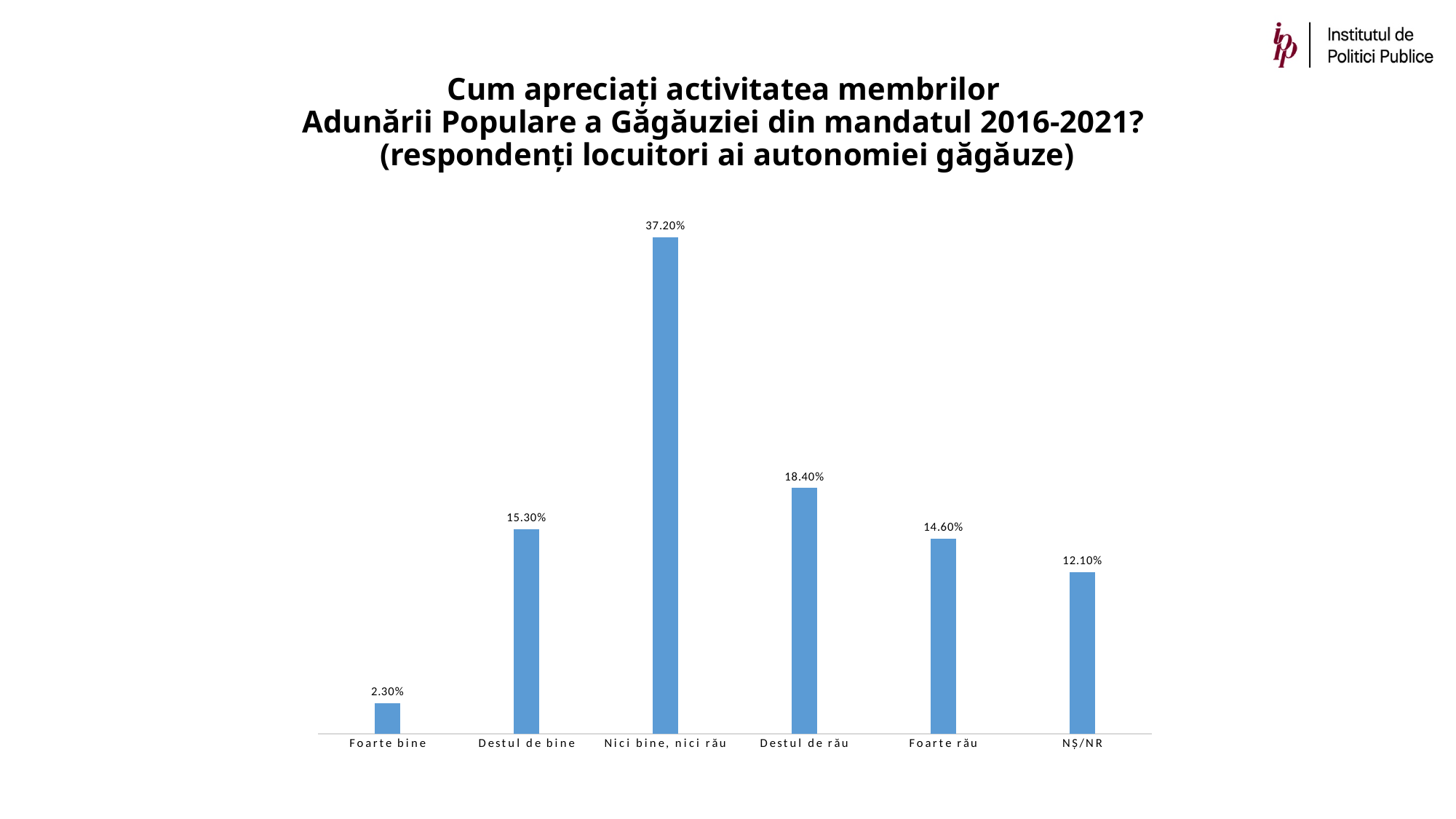
What is the value for "Foarte bine"? 2.30% What is the value for "Nici bine, nici rău"? 37.20% Which category has the highest value? Nici bine, nici rău How many categories are shown on the x axis? 6 What is the difference between the values for "Nici bine, nici rău" and "Foarte bine"? 34.90% What colour are the bars in the chart? Blue What is the value for "NȘ/NR"? 12.10% What is the value for "Destul de rău"? 18.40% What is the difference between the values for "Destul de rău" and "Destul de bine"? 3.10% What kind of chart is shown on the slide? Bar chart Which is larger, the value for "Foarte rău" or the value for "NȘ/NR"? Foarte rău Which category has the lowest value? Foarte bine